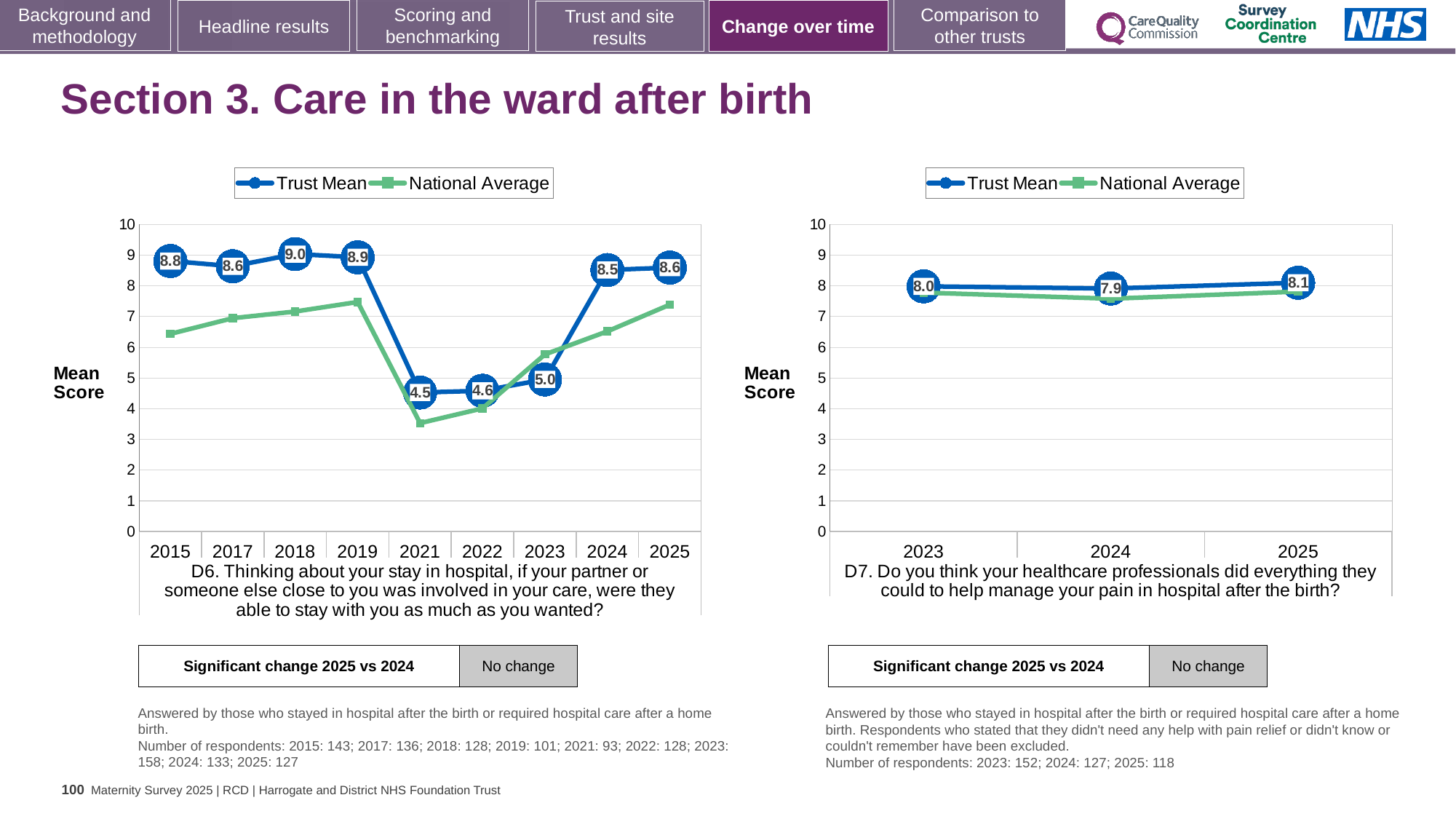
In the D7 chart on the right, which year has the highest Trust Mean score? 2025 In the D6 chart on the left, what is the Trust Mean score for 2021? 4.5 In the D6 chart on the left, what is the Trust Mean score for 2018? 9.0 In the D6 chart on the left, which year has the highest Trust Mean score? 2018 In the D7 chart on the right, is the Trust Mean for 2025 greater or less than 8? greater In the D6 chart on the left, is the National Average for 2015 greater or less than 7? less In the D6 chart on the left, which year has the lowest Trust Mean score? 2021 In the D6 chart on the left, how many years are plotted on the x axis? 9 In the D6 chart on the left, what is the difference between the Trust Mean scores for 2019 and 2023? 3.9 In the D7 chart on the right, what is the Trust Mean score for 2024? 7.9 What kind of chart is the D6 chart on the left? Line chart How many series does the legend of the D7 chart on the right list? 2